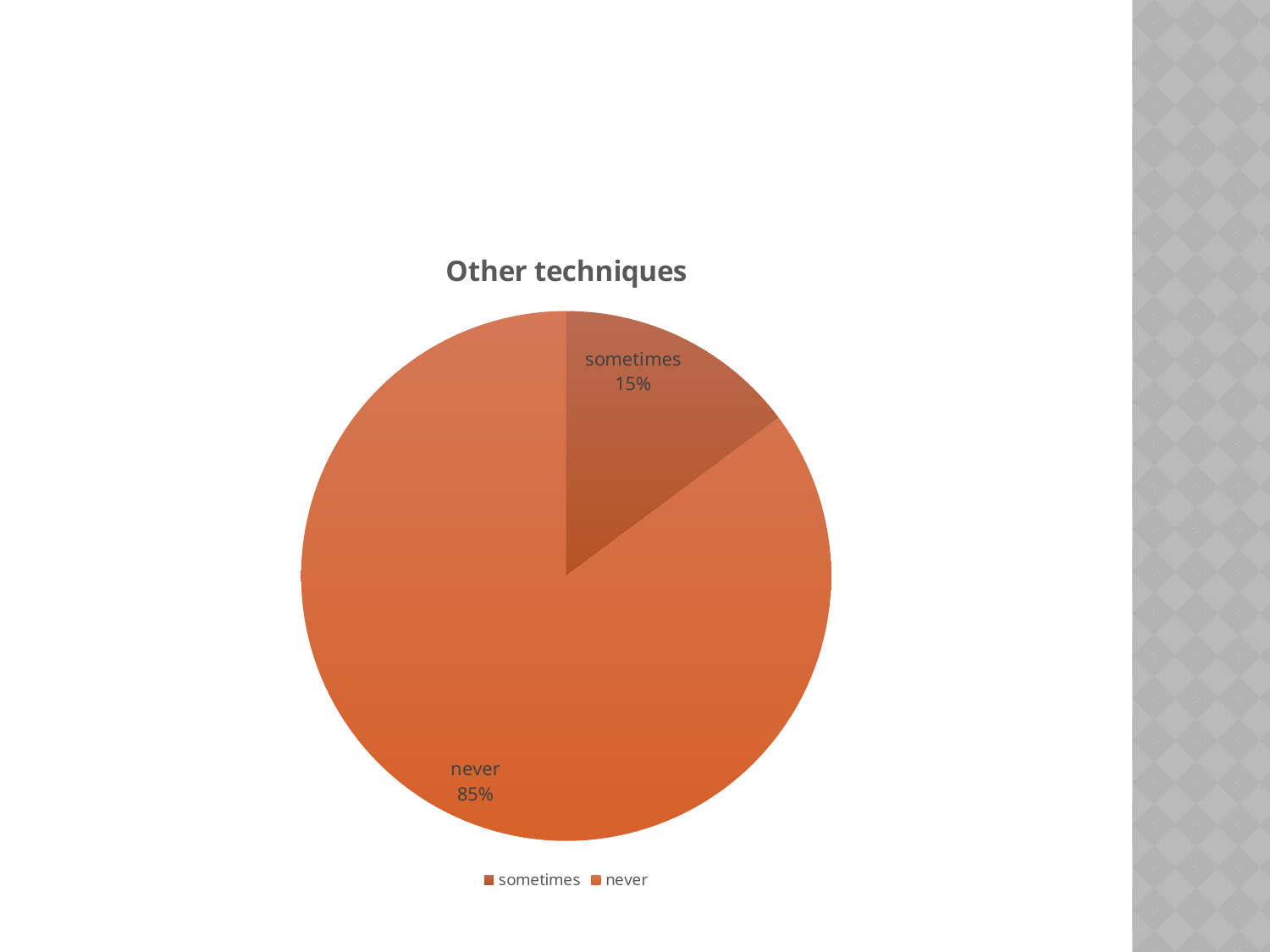
What share of the pie is labelled "sometimes"? 15% How many entries does the legend list? 2 What is the title of the chart? Other techniques What kind of chart is shown on the slide? pie chart Which slice of the pie is the smallest? sometimes What are the two categories listed in the legend? sometimes, never Which is larger, the "sometimes" slice or the "never" slice? never How many slices does the pie chart have? 2 Which slice of the pie is the largest? never What is the difference in percentage points between the "never" and "sometimes" slices? 70 What share of the pie is labelled "never"? 85%